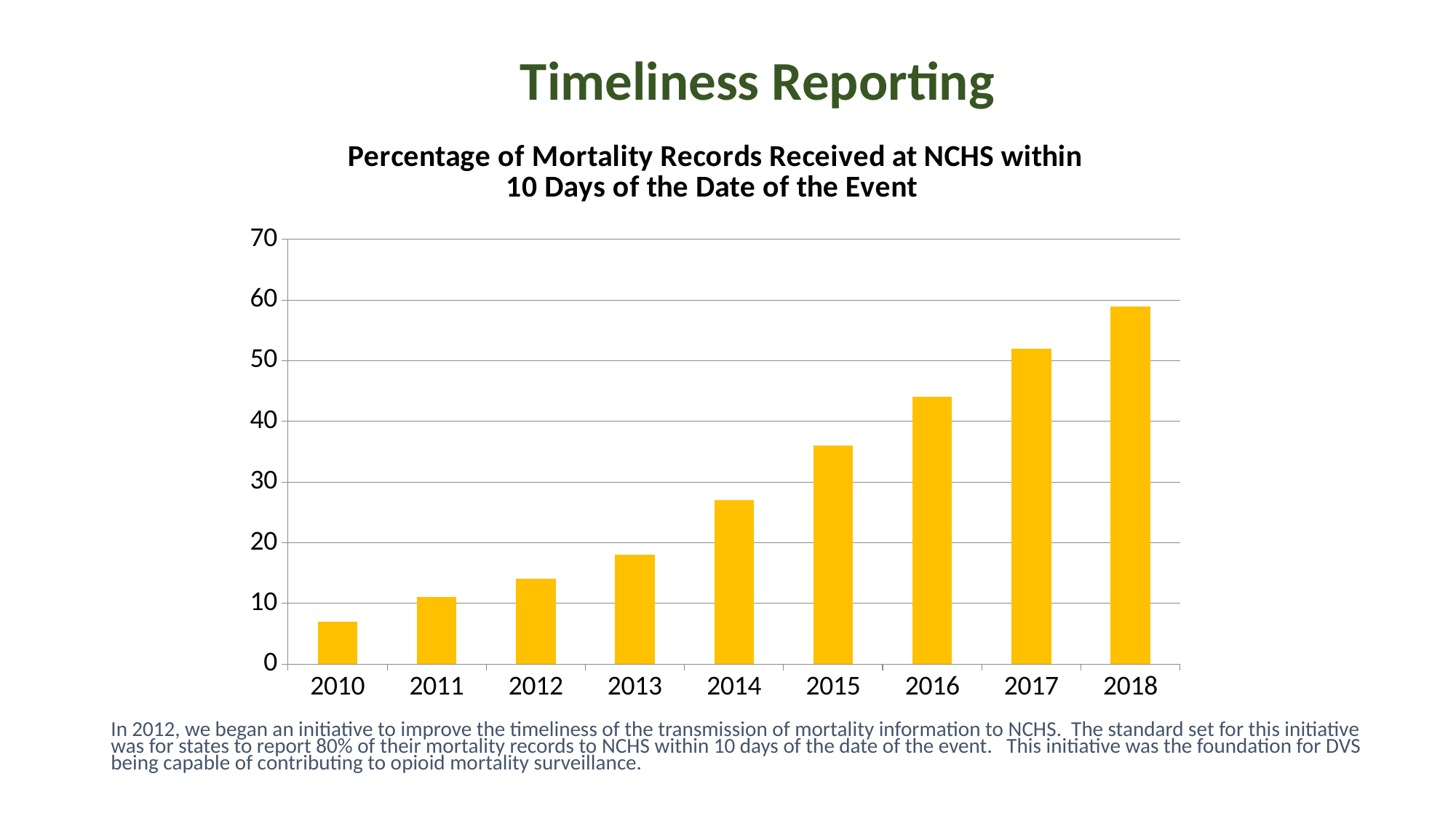
Which year has the lowest bar? 2010 What colour are the bars in the chart? yellow How many years are shown on the x axis of the chart? 9 What kind of chart is shown on the slide? bar chart Is the value for 2014 greater or less than 30? less Is the value for 2018 greater or less than 50? greater Is the value for 2016 greater or less than 40? greater Which is larger, the value for 2015 or the value for 2013? 2015 Which year has the highest bar? 2018 Do the values rise or fall from 2010 to 2018? rise What is the title of the chart? Percentage of Mortality Records Received at NCHS within 10 Days of the Date of the Event